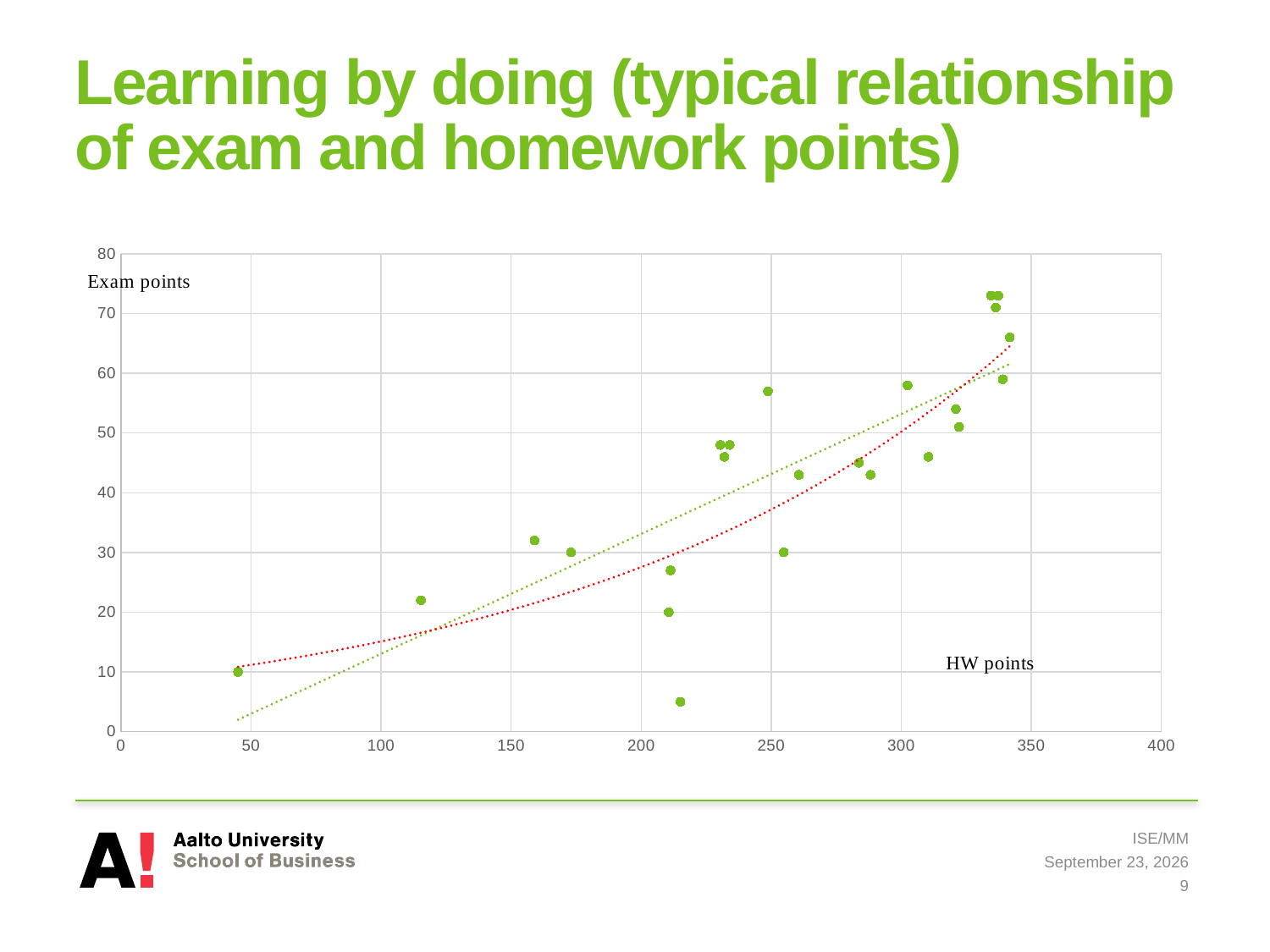
Is the lowest exam points value plotted greater or less than 10? less Do exam points generally rise or fall as HW points increase? rise What is the maximum value shown on the horizontal axis? 400 What kind of chart is shown on the slide? scatter plot Is the largest HW points value plotted greater or less than 350? less What is the label on the horizontal axis of the chart? HW points Is the highest exam points value plotted greater or less than 70? greater What is the label on the vertical axis of the chart? Exam points